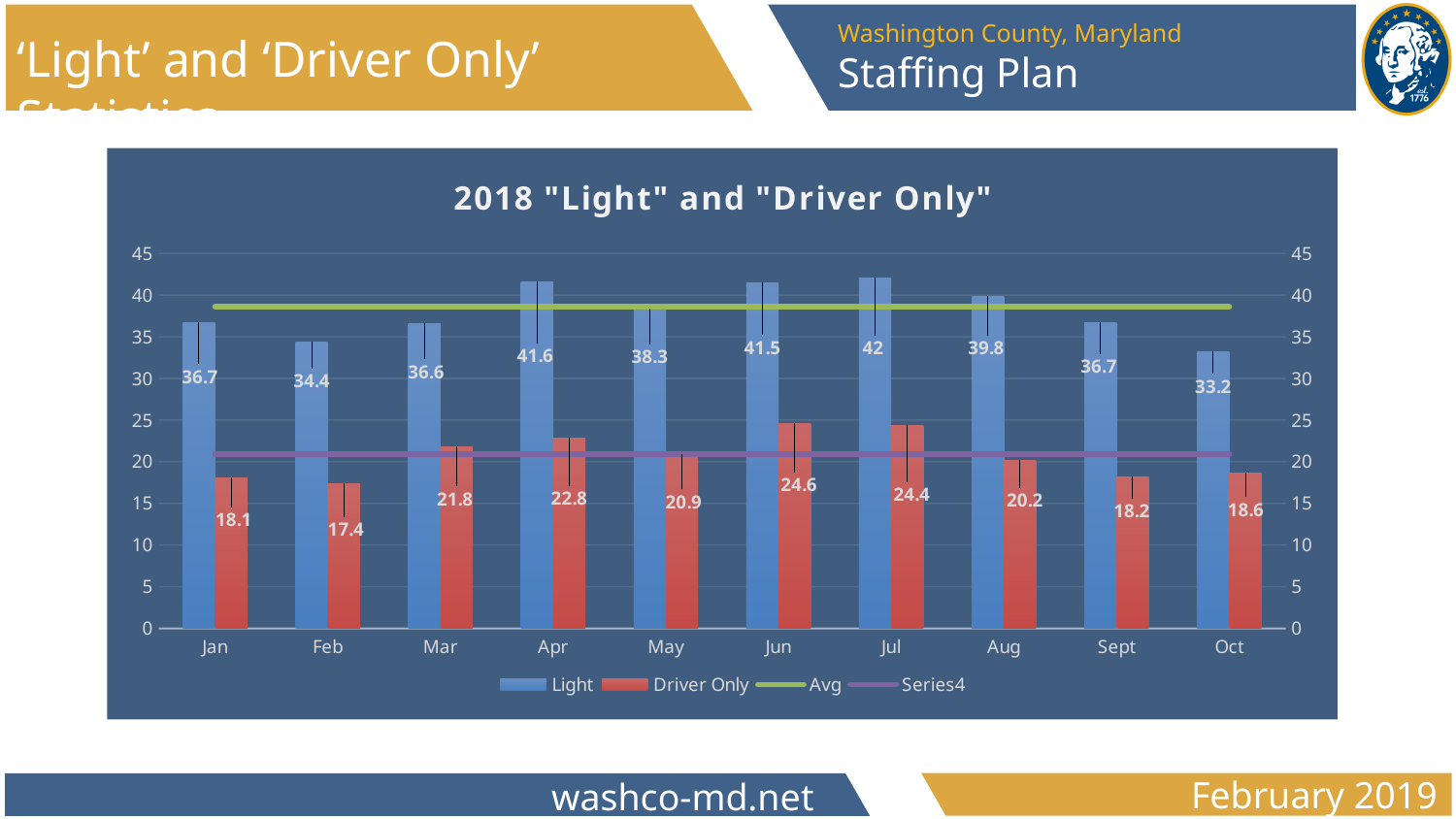
Which month has the highest Light value? Jul What is the title of the chart? 2018 "Light" and "Driver Only" Which month has the lowest Light value? Oct What is the value for Light in Jul? 42 Is the value of the Series4 line greater or less than 25? less What is the difference between the Light and Driver Only values in Jan? 18.6 What is the value for Driver Only in Apr? 22.8 How many series does the legend list? 4 Is the value of the Avg line greater or less than 35? greater How many months are shown on the x axis? 10 Which month has the lowest Driver Only value? Feb Which is larger, the Driver Only value in Mar or in May? Mar